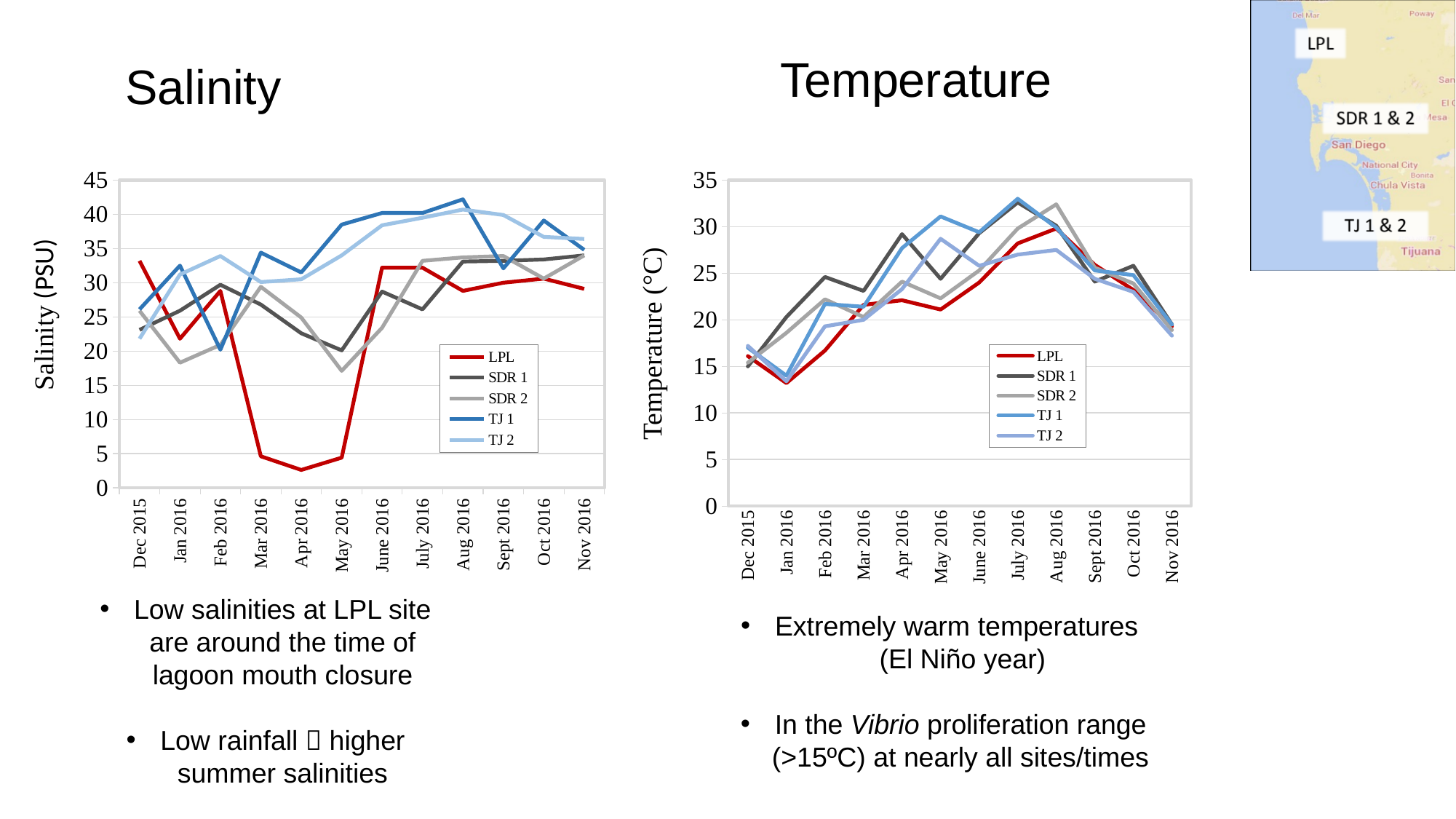
In the Temperature chart, is the LPL value for Jan 2016 greater or less than 15? less In the Temperature chart, which is larger in Apr 2016: SDR 1 or LPL? SDR 1 In the Temperature chart, do the values generally rise or fall from Dec 2015 to July 2016? rise How many months are shown on the x axis of the Salinity chart? 12 What type of chart is the Salinity chart? line chart In the Temperature chart, is the SDR 1 value for Apr 2016 greater or less than 25? greater In the Salinity chart, is the TJ 1 value for Aug 2016 greater or less than 40? greater How many series does the legend of the Temperature chart list? 5 In the Salinity chart, which series has the lowest value in Apr 2016? LPL In the Salinity chart, in which month does the LPL series reach its lowest value? Apr 2016 In the Salinity chart, which is larger in Apr 2016: LPL or TJ 1? TJ 1